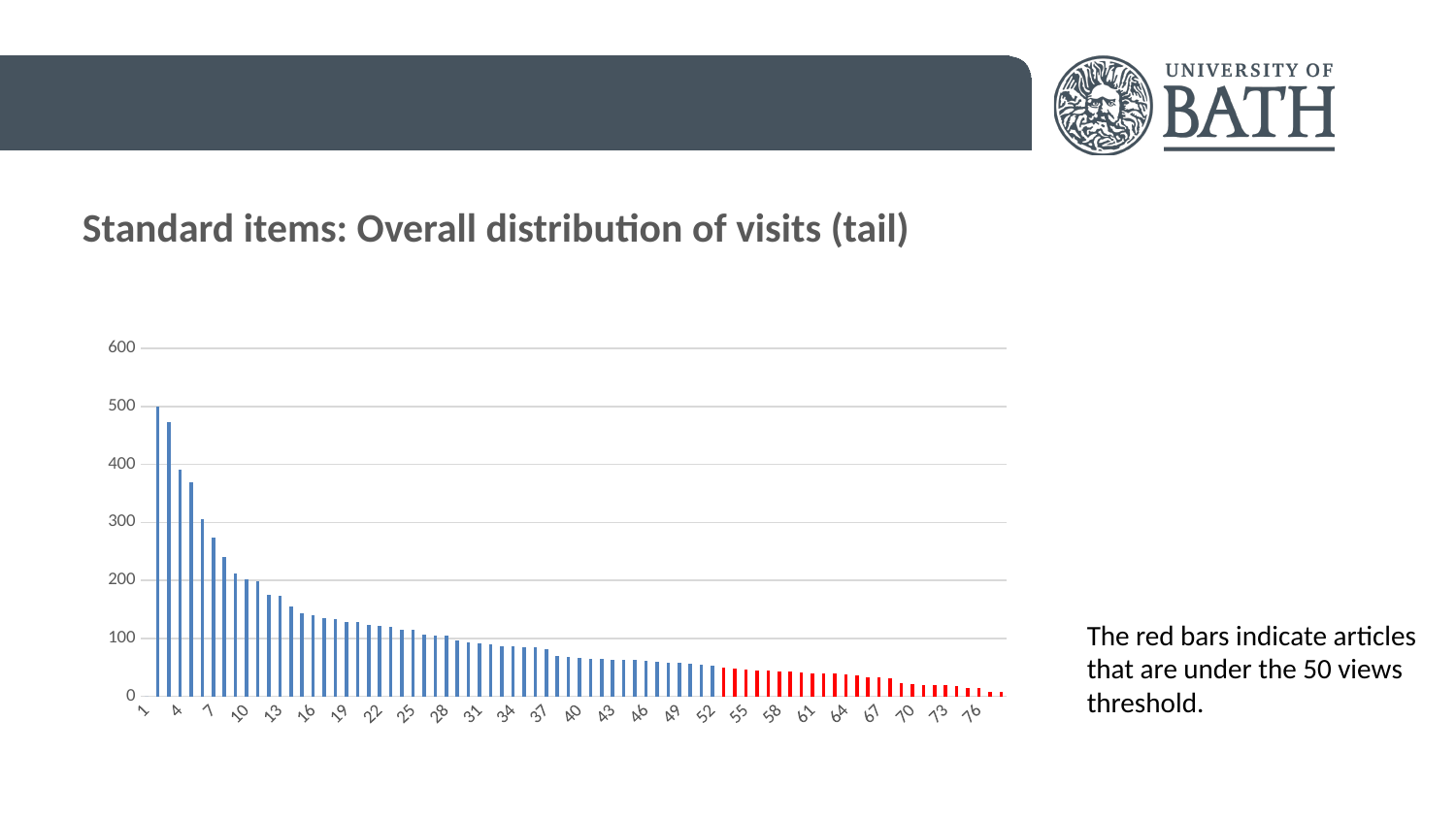
Is the value for category 25 greater or less than 200? less What kind of chart is shown on the slide? bar chart Is the value for category 55 greater or less than 100? less According to the slide, what do the red bars indicate? Articles that are under the 50 views threshold Which is larger, the value for category 7 or the value for category 13? 7 Is the value for category 4 greater or less than 300? greater What is the title of the chart on the slide? Standard items: Overall distribution of visits (tail) Which category has the highest bar? 2 Do the bar values rise or fall as you move from left to right along the x axis? fall